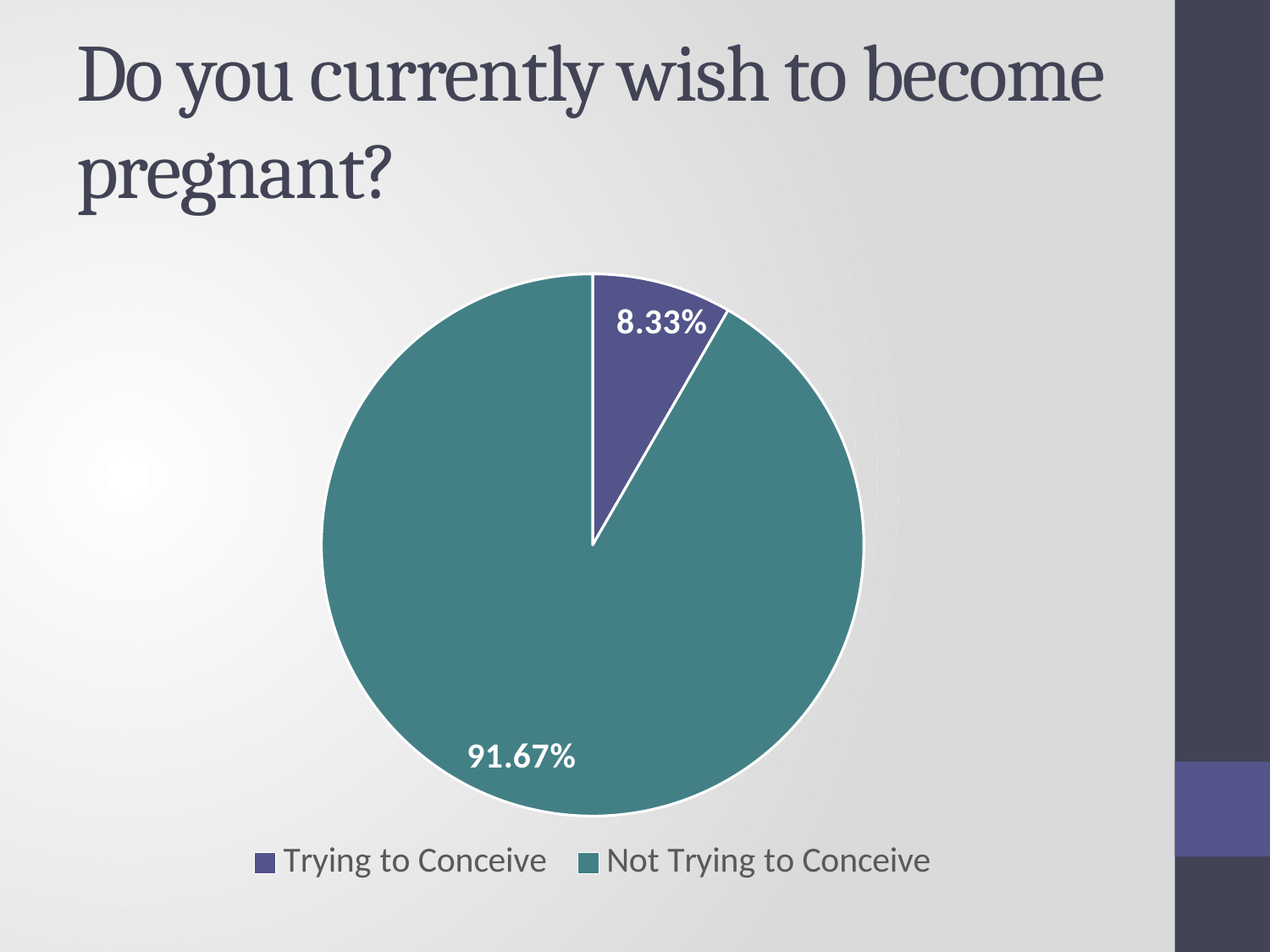
How many entries does the legend list? 2 What is the difference in percentage points between Not Trying to Conceive and Trying to Conceive? 83.34 What share of the pie does the Trying to Conceive slice represent? 8.33% Which is larger: the share for Trying to Conceive or the share for Not Trying to Conceive? Not Trying to Conceive How many slices does the pie chart have? 2 Which category has the largest share of the pie? Not Trying to Conceive What colour is the Not Trying to Conceive slice? teal What percentage of respondents are Trying to Conceive? 8.33% Which category has the smallest share of the pie? Trying to Conceive What kind of chart is shown on the slide? pie chart What percentage of respondents are Not Trying to Conceive? 91.67% What is the title of the slide containing the pie chart? Do you currently wish to become pregnant?